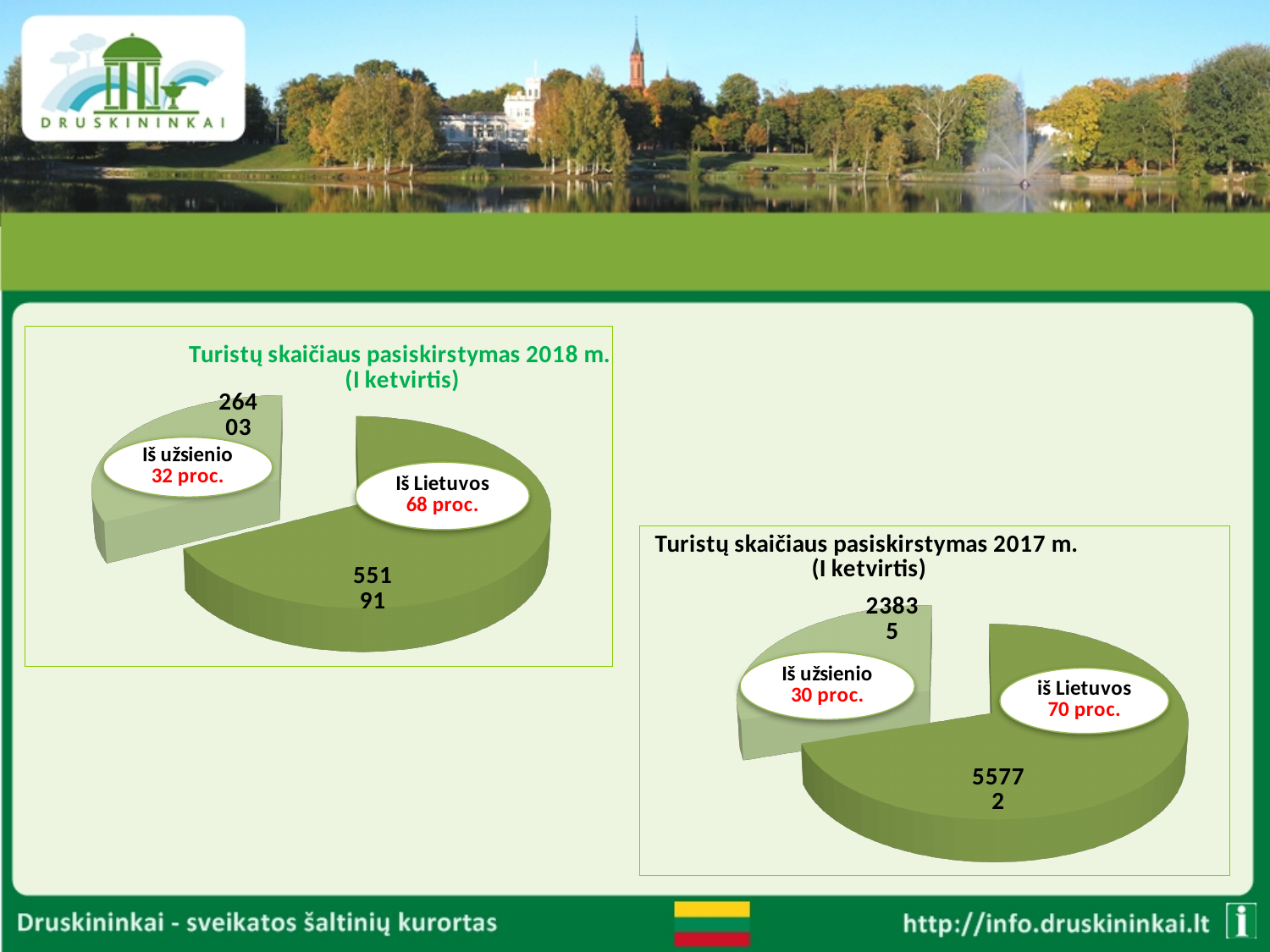
In the 2018 m. (I ketvirtis) chart, what is the value for 'Iš užsienio'? 26403 In the 2017 m. (I ketvirtis) chart, which slice is the largest? iš Lietuvos Which is larger: 'Iš užsienio' in the 2018 m. chart or 'Iš užsienio' in the 2017 m. chart? Iš užsienio in the 2018 m. chart In the 2017 m. (I ketvirtis) chart, what is the value for 'iš Lietuvos'? 55772 In the 2017 m. (I ketvirtis) chart, what share of the pie is 'Iš užsienio'? 30 proc. How many slices does the 2017 m. (I ketvirtis) pie chart have? 2 In the 2018 m. (I ketvirtis) chart, what is the value for 'Iš Lietuvos'? 55191 In the 2018 m. (I ketvirtis) chart, what is the difference between 'Iš Lietuvos' and 'Iš užsienio'? 28788 In the 2017 m. (I ketvirtis) chart, what is the value for 'Iš užsienio'? 23835 What kind of chart is the 'Turistų skaičiaus pasiskirstymas 2018 m. (I ketvirtis)' chart? pie chart In the 2018 m. (I ketvirtis) chart, what share of the pie is 'Iš Lietuvos'? 68 proc. In the 2018 m. (I ketvirtis) chart, what share of the pie is 'Iš užsienio'? 32 proc.